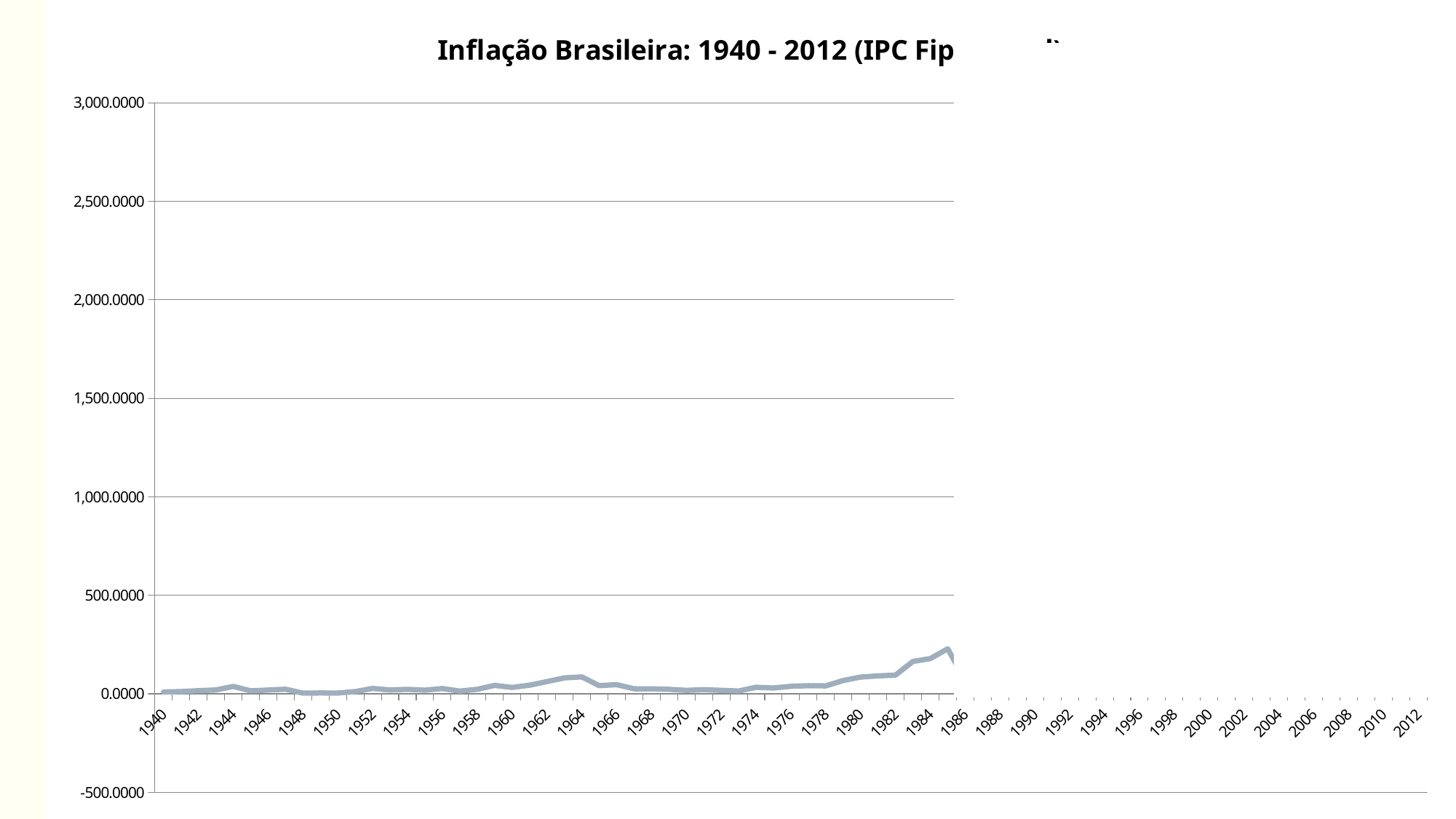
Between 1978 and 1984, does the line rise or fall? rise What kind of chart is shown on the slide? line chart Which year has the larger value, 1984 or 1950? 1984 Is the value for 1964 greater or less than 500? less Is the value for 1950 greater or less than 500? less Between 1964 and 1966, does the line rise or fall? fall Which year has the larger value, 1964 or 1970? 1964 What is the first year shown on the horizontal axis? 1940 What is the highest value labelled on the vertical axis? 3,000.0000 Is the value for 1984 greater or less than 500? less